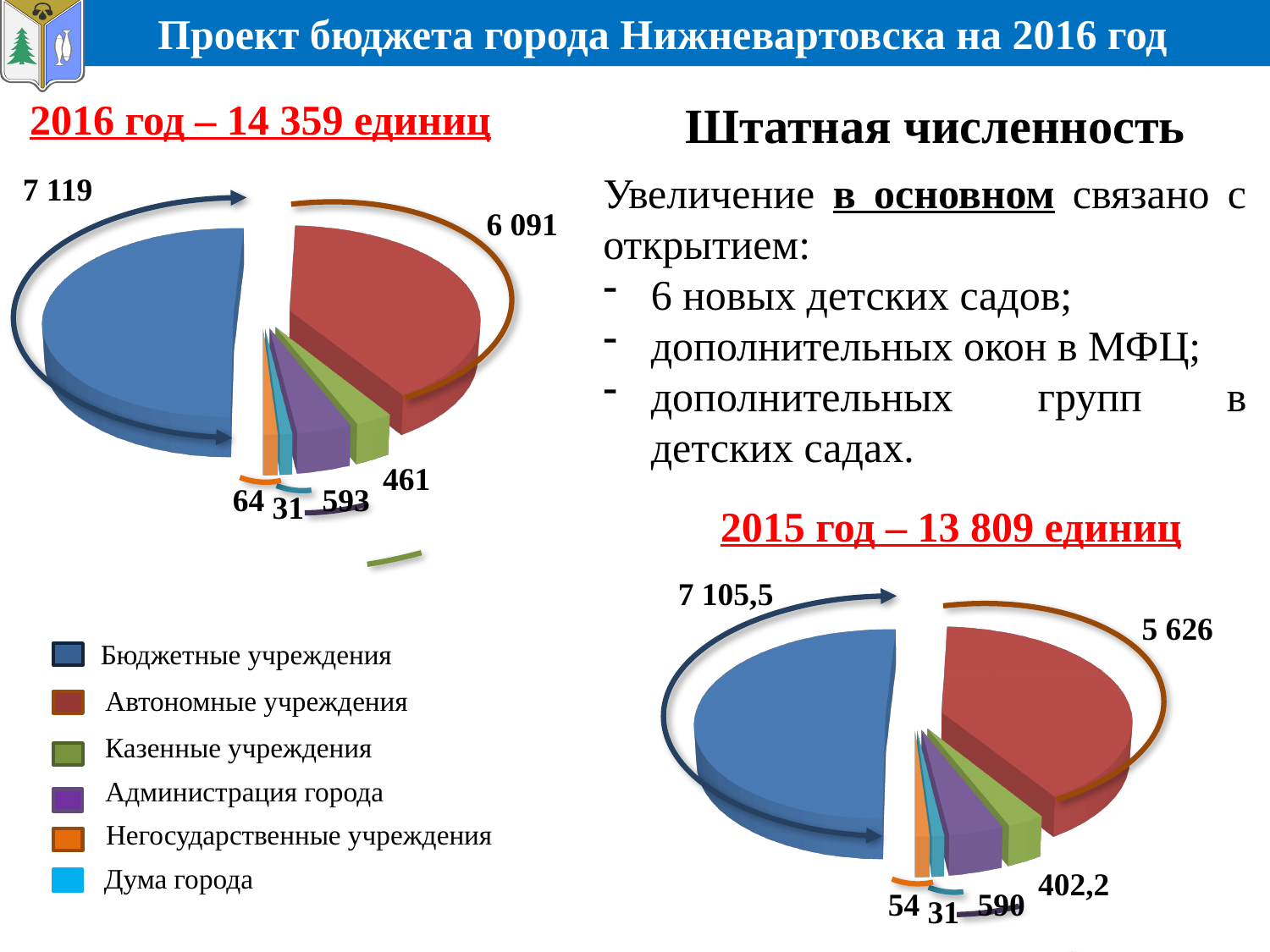
In the 2016 pie chart (2016 год – 14 359 единиц), what is the value for Бюджетные учреждения? 7 119 What is the difference between the Автономные учреждения value in the 2016 chart and in the 2015 chart? 465 In the 2016 pie chart, which category has the largest slice? Бюджетные учреждения In the 2015 pie chart (2015 год – 13 809 единиц), what is the value for Бюджетные учреждения? 7 105,5 Which colour represents Негосударственные учреждения in the legend? Orange In the 2016 pie chart, what is the difference between Бюджетные учреждения and Автономные учреждения? 1 028 In the 2016 pie chart, what is the value for Автономные учреждения? 6 091 In the 2015 pie chart, which category has the smallest slice? Дума города In the 2015 pie chart, which is larger: Администрация города or Казенные учреждения? Администрация города In the 2015 pie chart, what is the value for Казенные учреждения? 402,2 How many categories does the 2016 pie chart contain? 6 What type of chart is used to show the 2015 staff numbers? Pie chart